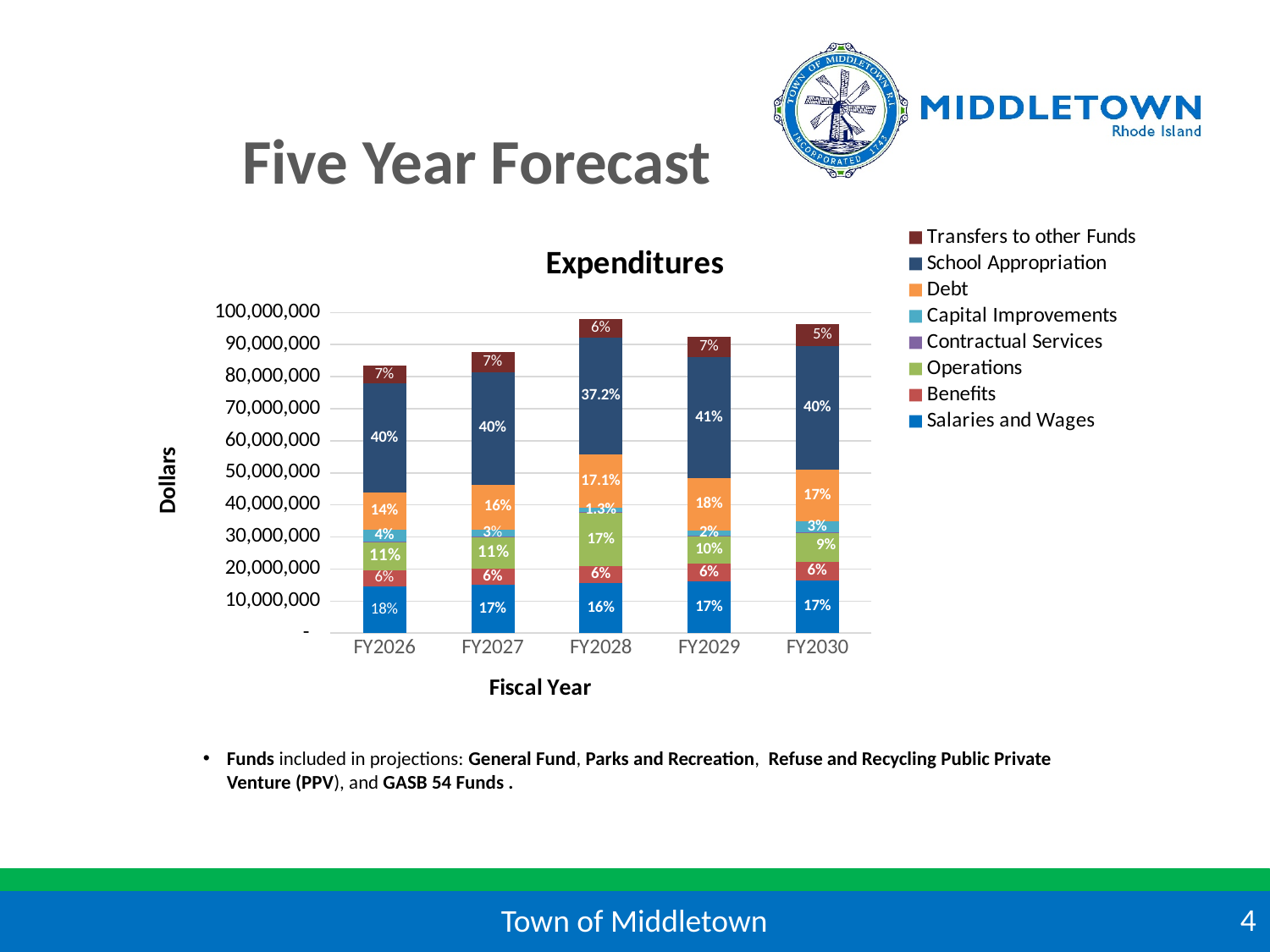
Which fiscal year has the larger Operations percentage label, FY2028 or FY2030? FY2028 How many series does the legend of the Expenditures chart list? 8 Is the total height of the FY2026 bar greater or less than 90,000,000? less What kind of chart is shown under the title "Expenditures"? Stacked bar chart What percentage label is shown for Debt in FY2029? 18% Which fiscal year has the lowest total expenditures bar? FY2026 What percentage label is shown for School Appropriation in FY2028? 37.2% By how many percentage points does the Debt label in FY2027 exceed the Debt label in FY2026? 2 percentage points What percentage label is shown for Salaries and Wages in FY2026? 18% What percentage label is shown for Capital Improvements in FY2028? 1.3% Is the total height of the FY2028 bar greater or less than 90,000,000? greater How many fiscal years are plotted on the x axis of the Expenditures chart? 5